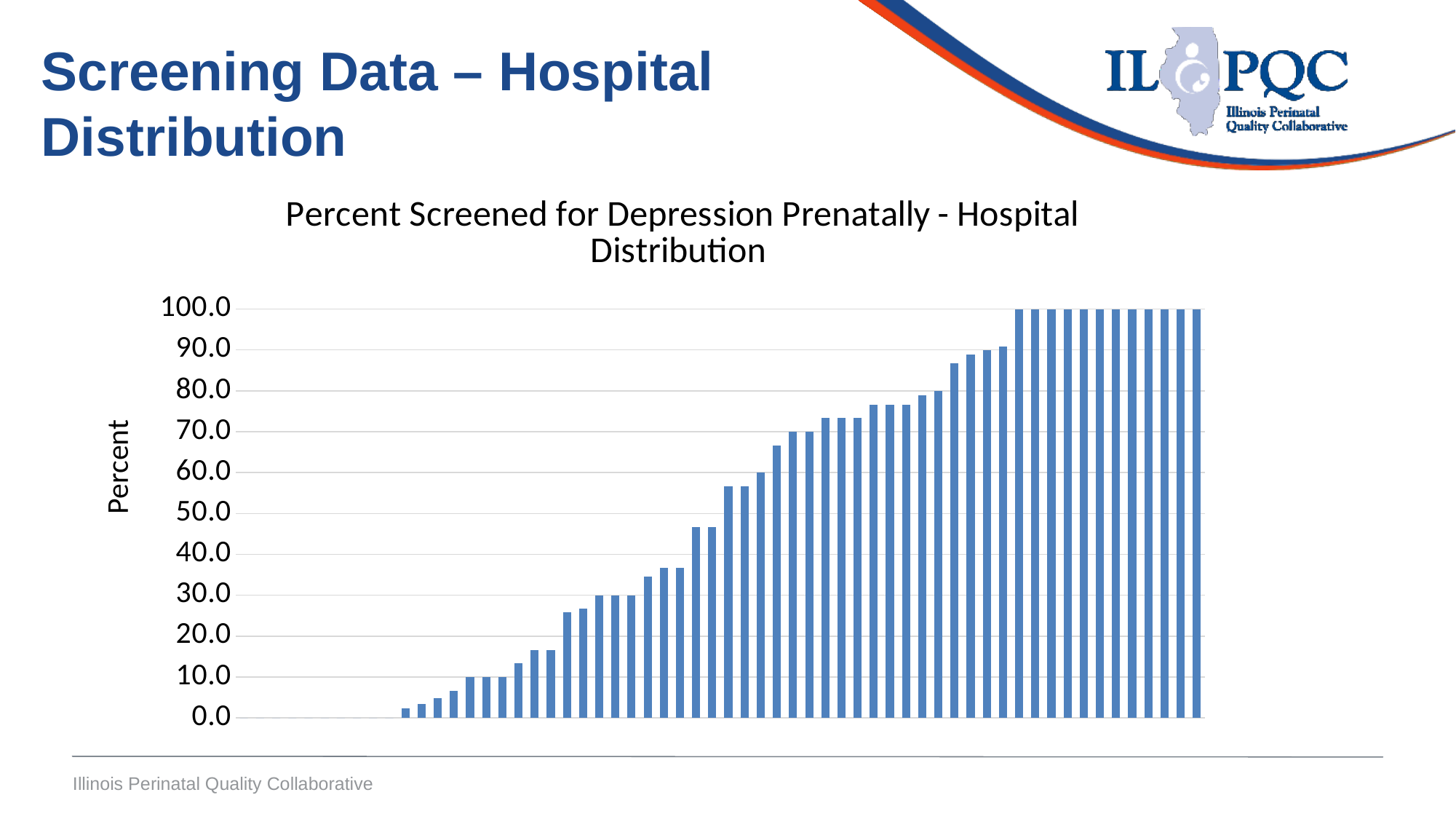
Is the value of the shortest visible bar greater or less than 10.0? less What is the value of the tallest bars in the chart? 100.0 Is the value of the rightmost bar greater or less than 90.0? greater Is the value of the bar in the middle of the chart greater or less than 40.0? greater Is the value of the leftmost bar greater or less than 10.0? less Which is larger, the leftmost bar or the rightmost bar? The rightmost bar What is the label on the vertical axis of the chart? Percent What kind of chart is shown on the slide? Bar chart What is the title of the chart? Percent Screened for Depression Prenatally - Hospital Distribution Do the bar values rise or fall from left to right across the chart? Rise